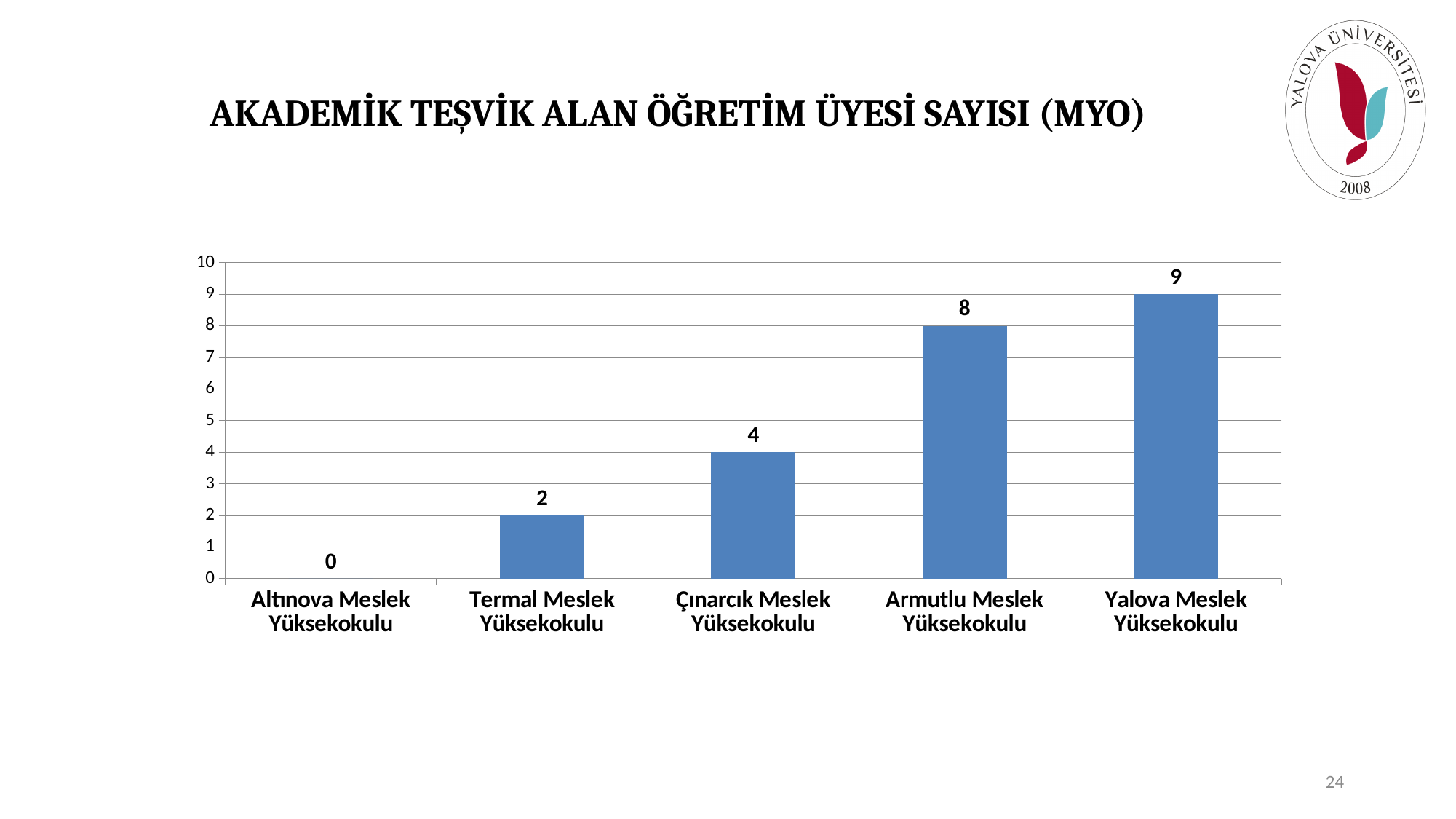
How many categories are shown on the x axis? 5 What is the value for Altınova Meslek Yüksekokulu? 0 What is the title of the slide? AKADEMİK TEŞVİK ALAN ÖĞRETİM ÜYESİ SAYISI (MYO) What is the value for Termal Meslek Yüksekokulu? 2 What kind of chart is shown on the slide? bar chart What is the difference between the values for Yalova Meslek Yüksekokulu and Çınarcık Meslek Yüksekokulu? 5 Which category has the highest value? Yalova Meslek Yüksekokulu Do the values rise or fall from left to right along the x axis? rise Which is larger, the value for Armutlu Meslek Yüksekokulu or Termal Meslek Yüksekokulu? Armutlu Meslek Yüksekokulu What is the value for Armutlu Meslek Yüksekokulu? 8 Is the value for Çınarcık Meslek Yüksekokulu greater or less than 5? less Which category has the lowest value? Altınova Meslek Yüksekokulu